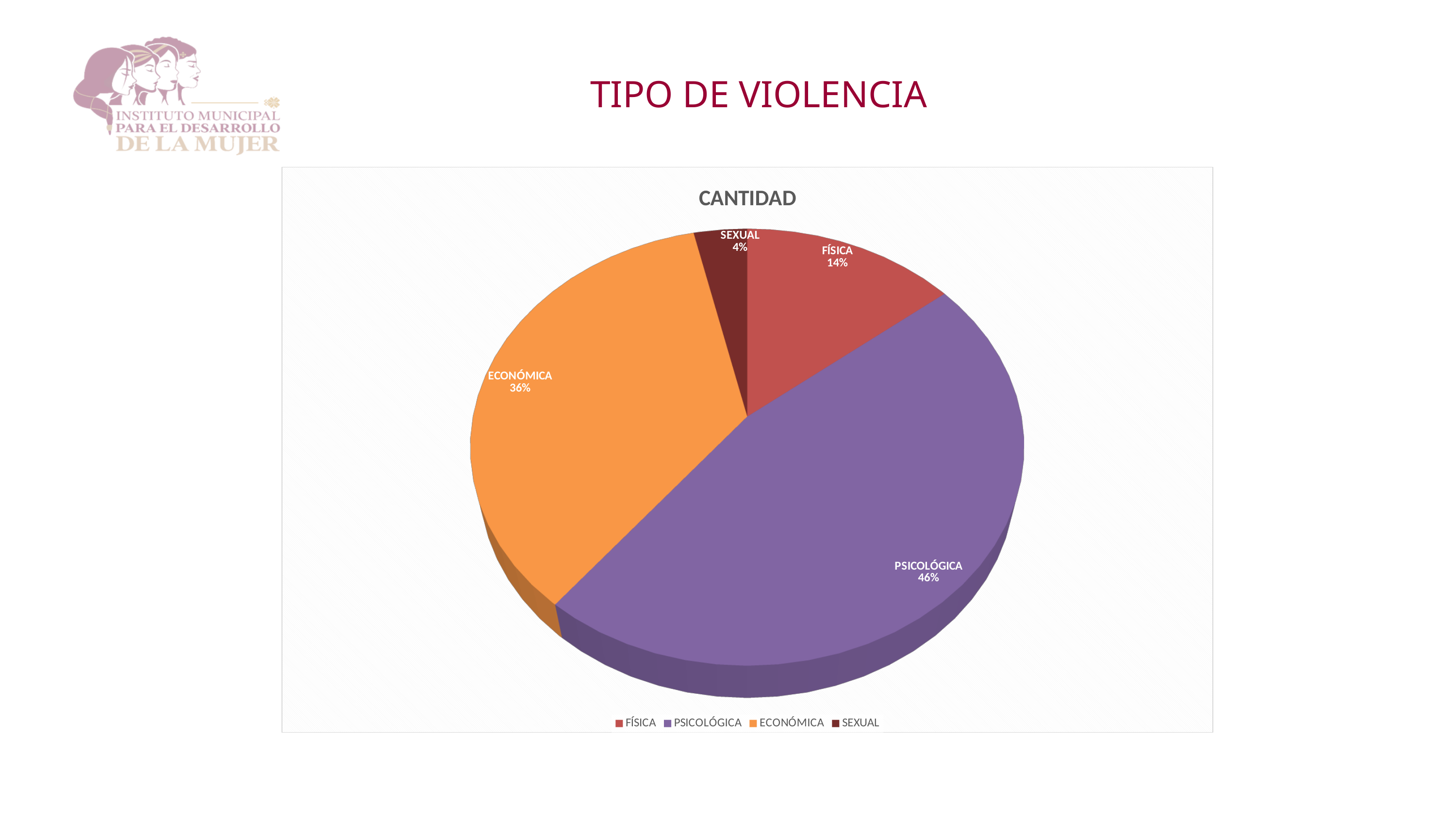
What is the difference in percentage points between PSICOLÓGICA and ECONÓMICA? 10 Which category has the largest slice of the pie? PSICOLÓGICA What percentage share does ECONÓMICA have? 36% Which is larger, FÍSICA or SEXUAL? FÍSICA What is the chart's title? CANTIDAD What type of chart is shown on the slide? Pie chart What percentage share does FÍSICA have? 14% How many categories are shown in the pie chart? 4 What percentage share does PSICOLÓGICA have? 46% What percentage share does SEXUAL have? 4% What colour is the ECONÓMICA slice? Orange Which category has the smallest slice of the pie? SEXUAL